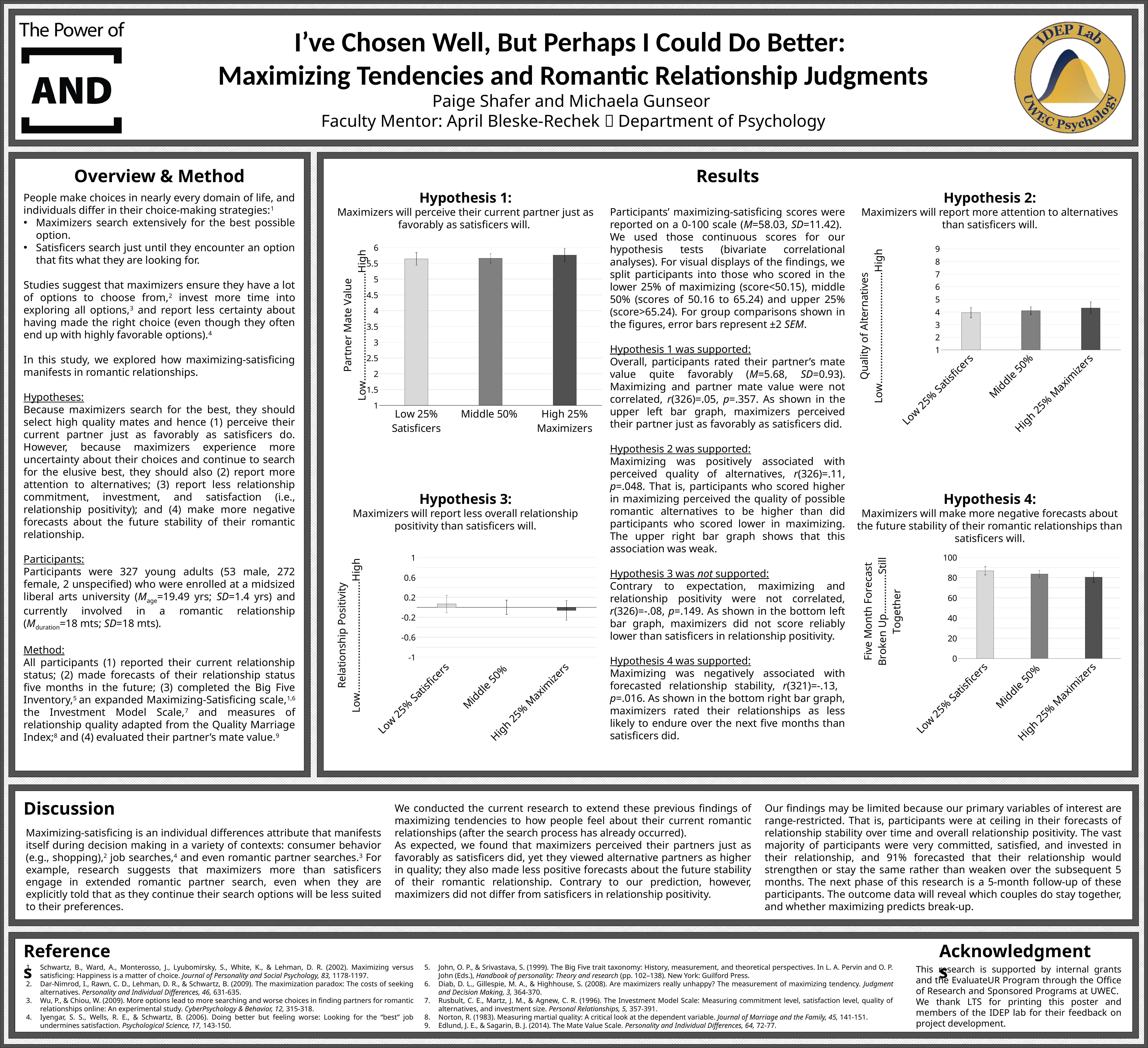
In the Hypothesis 3 chart, is the value for Low 25% Satisficers greater or less than 0.6? less In the Hypothesis 1 chart, is the value for Middle 50% greater or less than 5? greater In the Hypothesis 2 chart, what is the highest tick shown on the y axis? 9 In the Hypothesis 1 chart, how many groups are plotted on the x axis? 3 In the Hypothesis 3 chart, how many groups are plotted? 3 What is the y-axis label of the Hypothesis 1 chart? Partner Mate Value In the Hypothesis 2 chart, is the value for High 25% Maximizers greater or less than 5? less In the Hypothesis 4 chart, which is larger, the value for Low 25% Satisficers or the value for High 25% Maximizers? Low 25% Satisficers What kind of chart is shown under Hypothesis 1? Bar chart